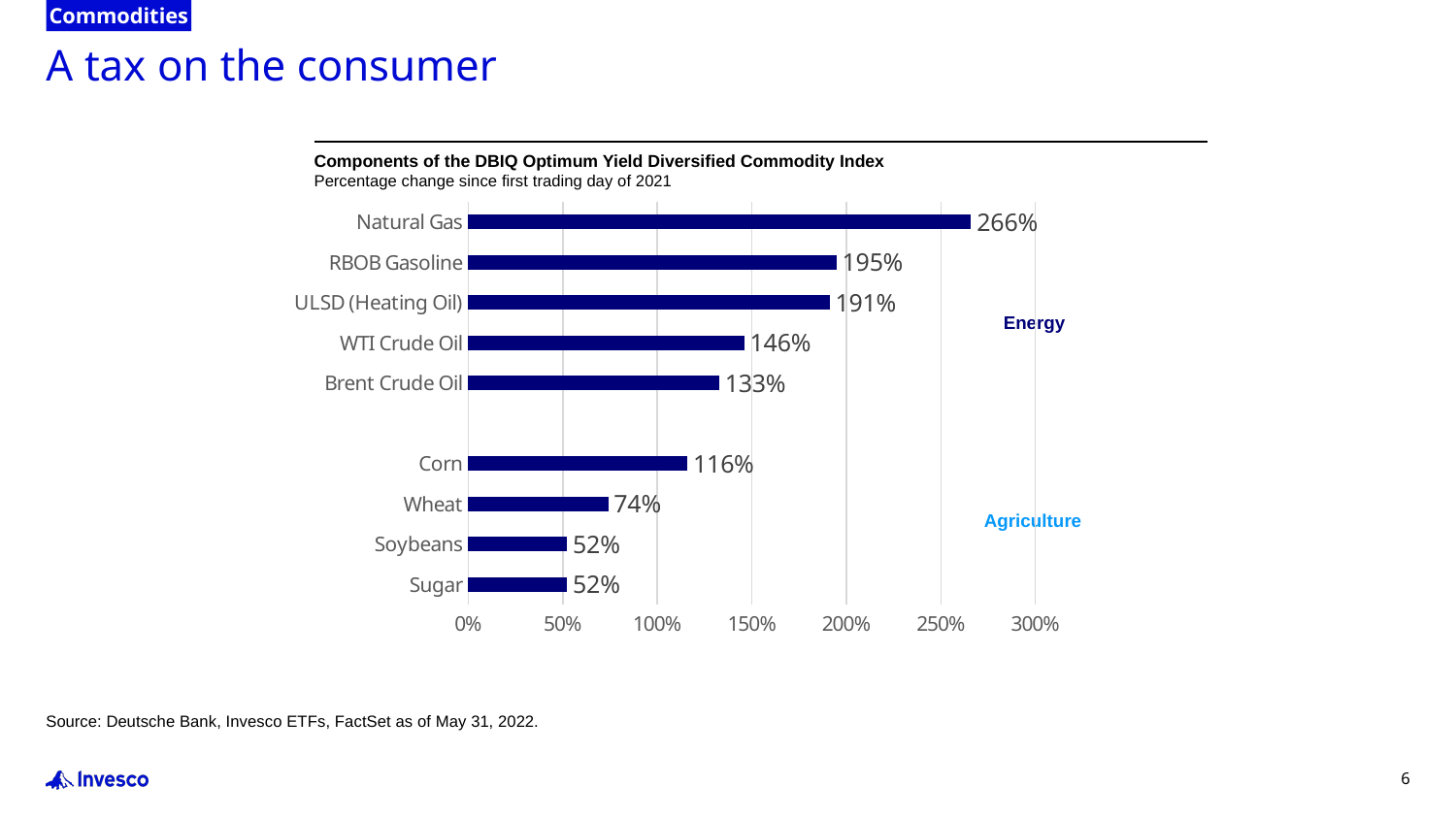
Is the value for ULSD (Heating Oil) greater or less than 150%? greater What is the difference between the percentage change for Corn and Sugar? 64% What is the percentage change for Brent Crude Oil? 133% Which two commodities share the lowest percentage change? Soybeans and Sugar What is the percentage change for Wheat? 74% What kind of chart is shown on the slide? Bar chart Which has a larger percentage change, Corn or Brent Crude Oil? Brent Crude Oil What are the two group labels shown next to the bars? Energy and Agriculture What is the percentage change for Natural Gas? 266% What is the difference between the percentage change for RBOB Gasoline and WTI Crude Oil? 49% Which commodity has the highest percentage change? Natural Gas How many commodities are shown in the chart? 9